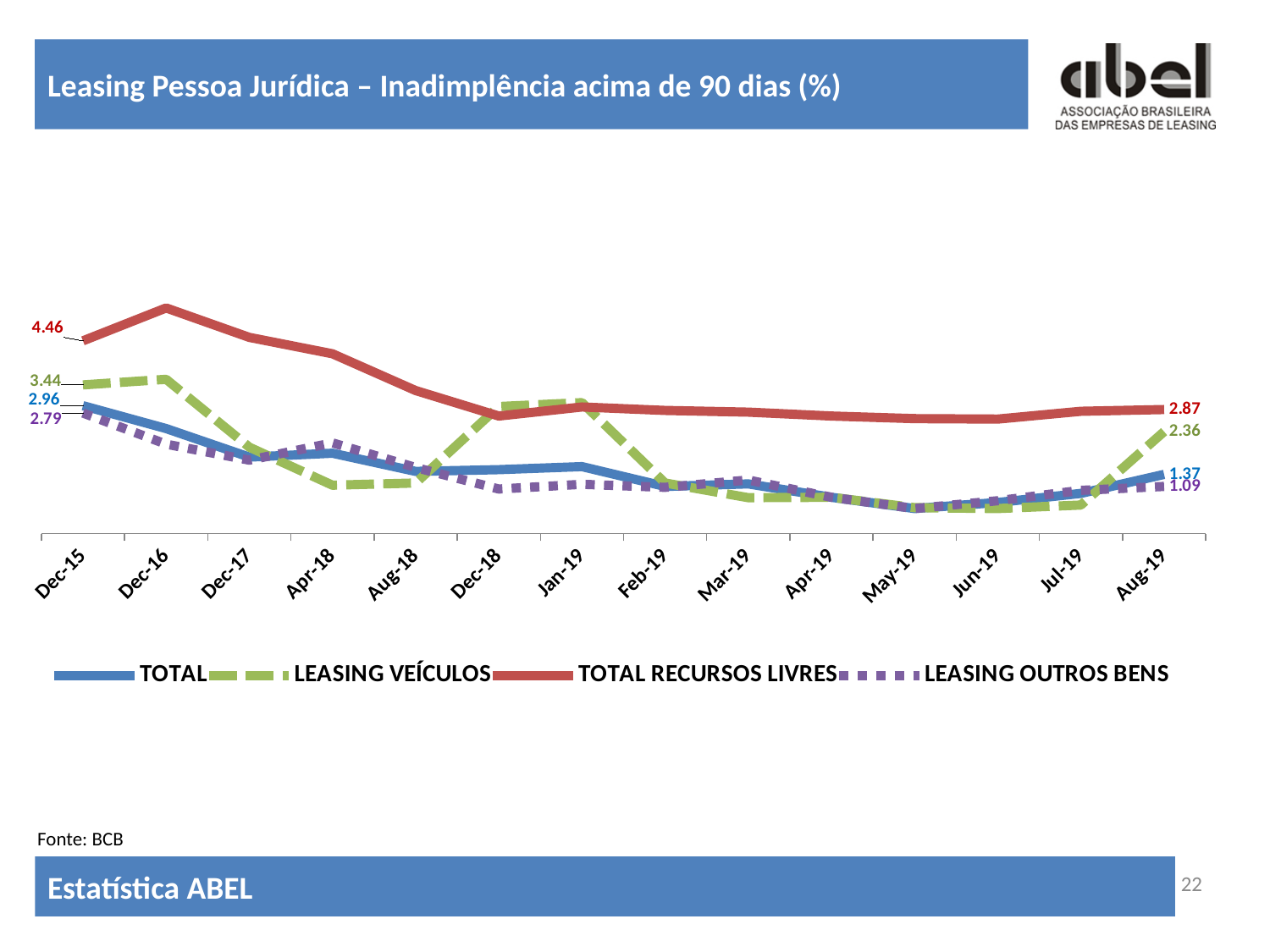
What type of chart is shown on the slide? Line chart How many series does the legend list? 4 Which series has the lowest value at Dec-15? LEASING OUTROS BENS What is the value of LEASING OUTROS BENS at Dec-15? 2.79 Does the TOTAL series rise or fall from Dec-15 to Aug-19? Fall Which is larger at Aug-19: the value for TOTAL or the value for LEASING OUTROS BENS? TOTAL What is the value of TOTAL at Aug-19? 1.37 What is the value of LEASING VEÍCULOS at Aug-19? 2.36 What is the difference between the TOTAL RECURSOS LIVRES values at Dec-15 and Aug-19? 1.59 Which series has the highest value at Aug-19? TOTAL RECURSOS LIVRES How many dates are shown on the x axis? 14 What is the value of TOTAL RECURSOS LIVRES at Dec-15? 4.46